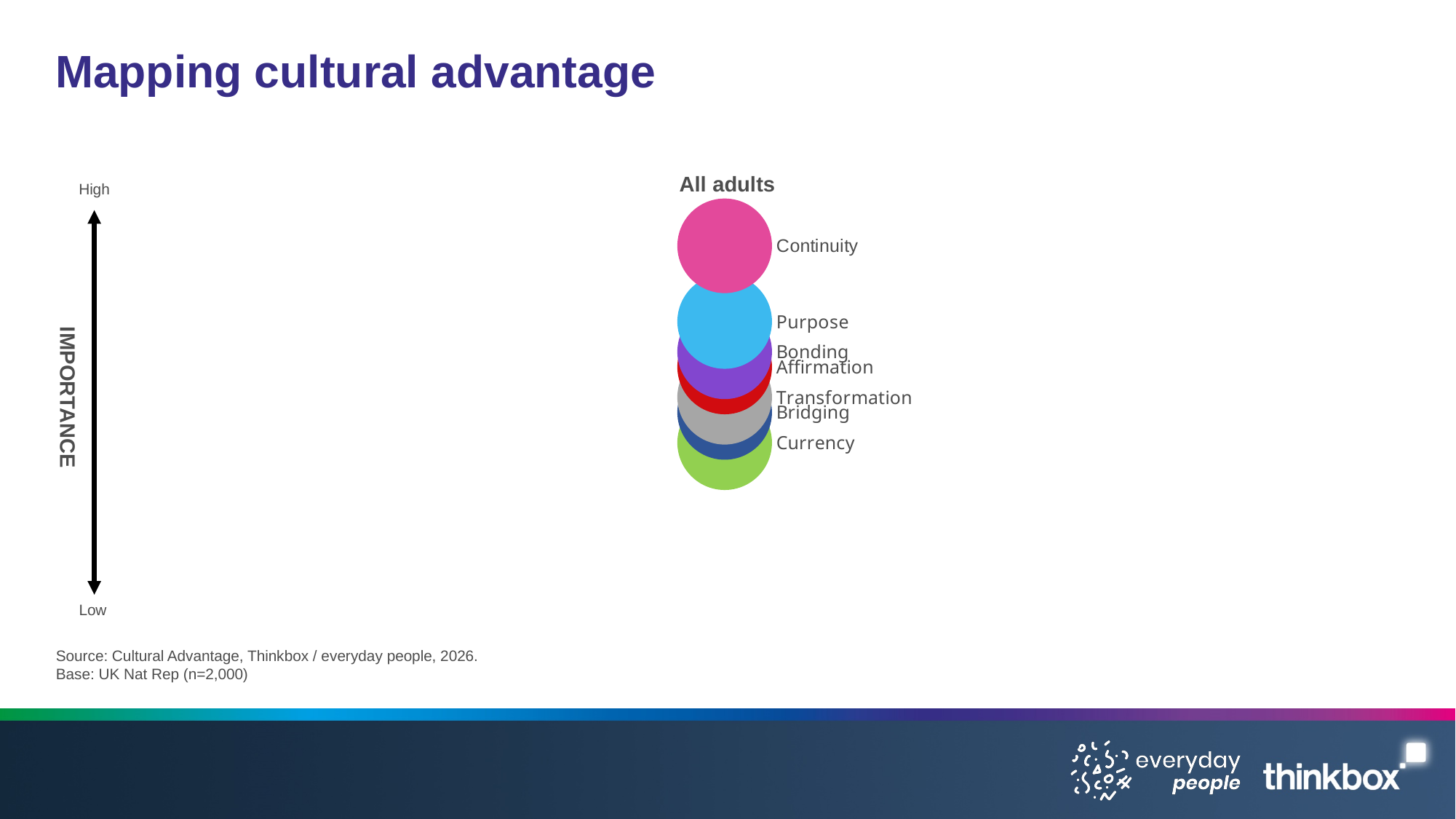
What is the label of the vertical axis? IMPORTANCE Which is placed higher on the Importance axis, Purpose or Bridging? Purpose How many categories (bubbles) are plotted on the chart? 7 Which is placed higher on the Importance axis, Continuity or Purpose? Continuity Which is placed higher on the Importance axis, Continuity or Currency? Continuity Which category is placed lowest on the Importance axis? Currency What kind of chart is shown on the slide? Bubble chart What audience group is the column of bubbles labelled as? All adults Which category is placed highest on the Importance axis? Continuity What is the title of the slide? Mapping cultural advantage